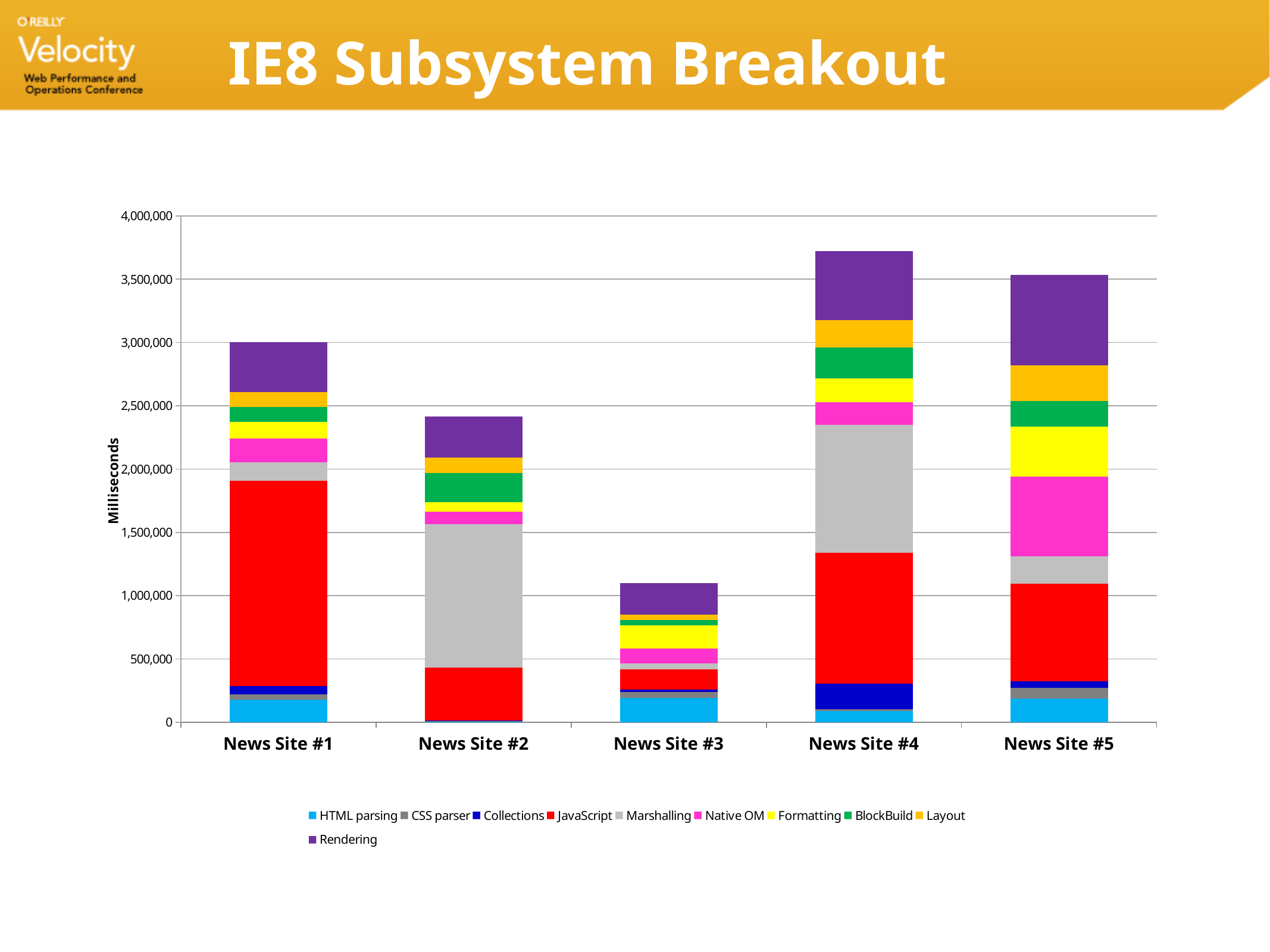
Is the total bar height for News Site #4 greater or less than 3,500,000? greater What kind of chart is shown on the slide? Stacked bar chart What is the label on the vertical axis? Milliseconds How many news sites are plotted along the x axis? 5 Is the total bar height for News Site #2 greater or less than 2,500,000? less Is the total bar height for News Site #3 greater or less than 1,500,000? less What is the title of the slide containing the chart? IE8 Subsystem Breakout Which has the taller stacked bar, News Site #1 or News Site #2? News Site #1 Which news site has the tallest stacked bar overall? News Site #4 How many series does the legend list? 10 Which news site has the shortest stacked bar overall? News Site #3